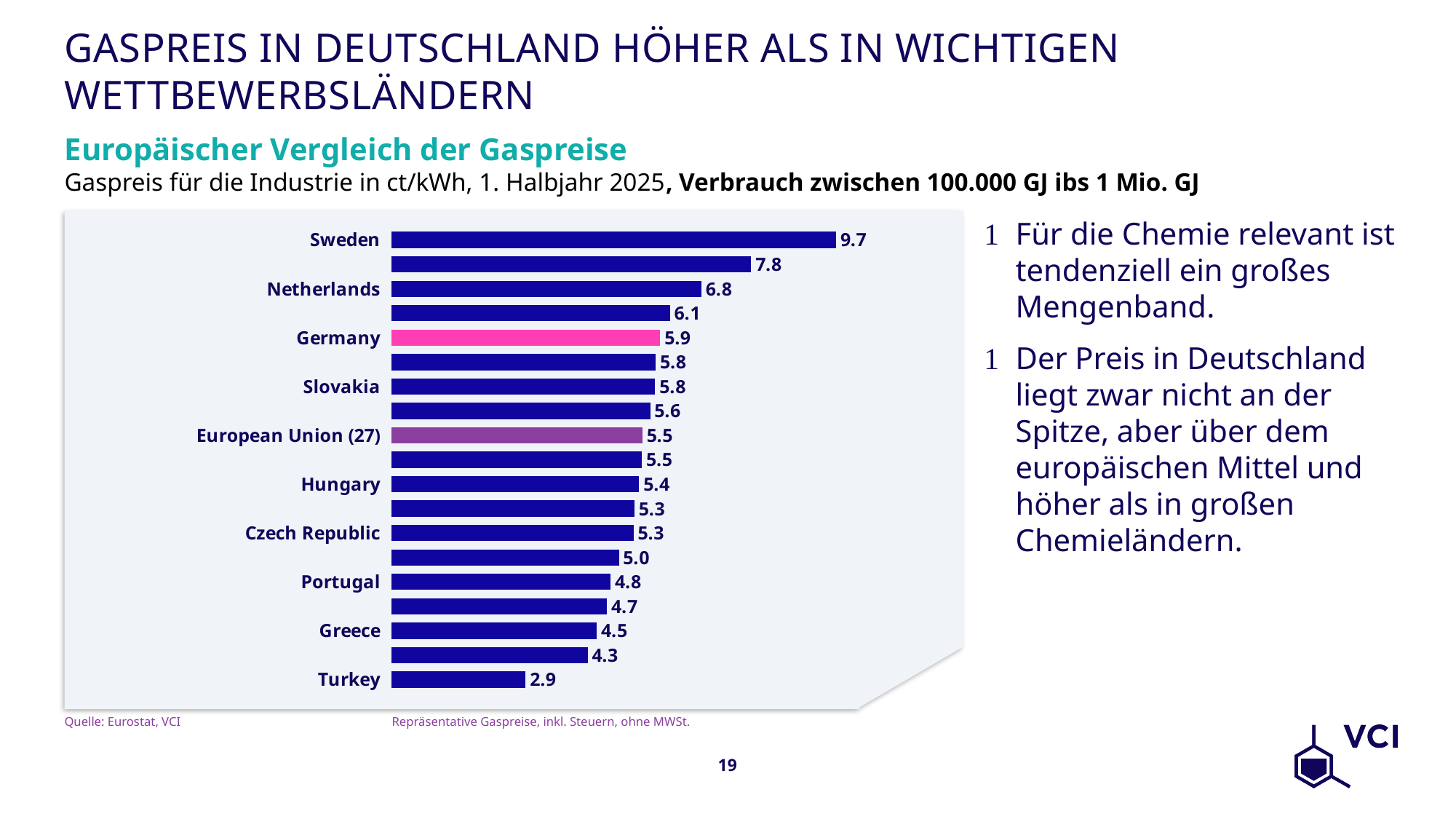
Which labelled country has the highest gas price? Sweden Which has a higher gas price, Netherlands or Hungary? Netherlands How much higher is the gas price in Germany than the European Union (27) value? 0.4 Which labelled country has the lowest gas price? Turkey What kind of chart is shown on the slide? Bar chart What is the value shown for European Union (27)? 5.5 What is the difference between the gas prices of Sweden and Turkey? 6.8 How many bars are plotted in the chart? 19 What is the gas price for Germany? 5.9 What is the gas price for Turkey? 2.9 What colour is the bar for Germany? Pink What is the gas price for Sweden? 9.7